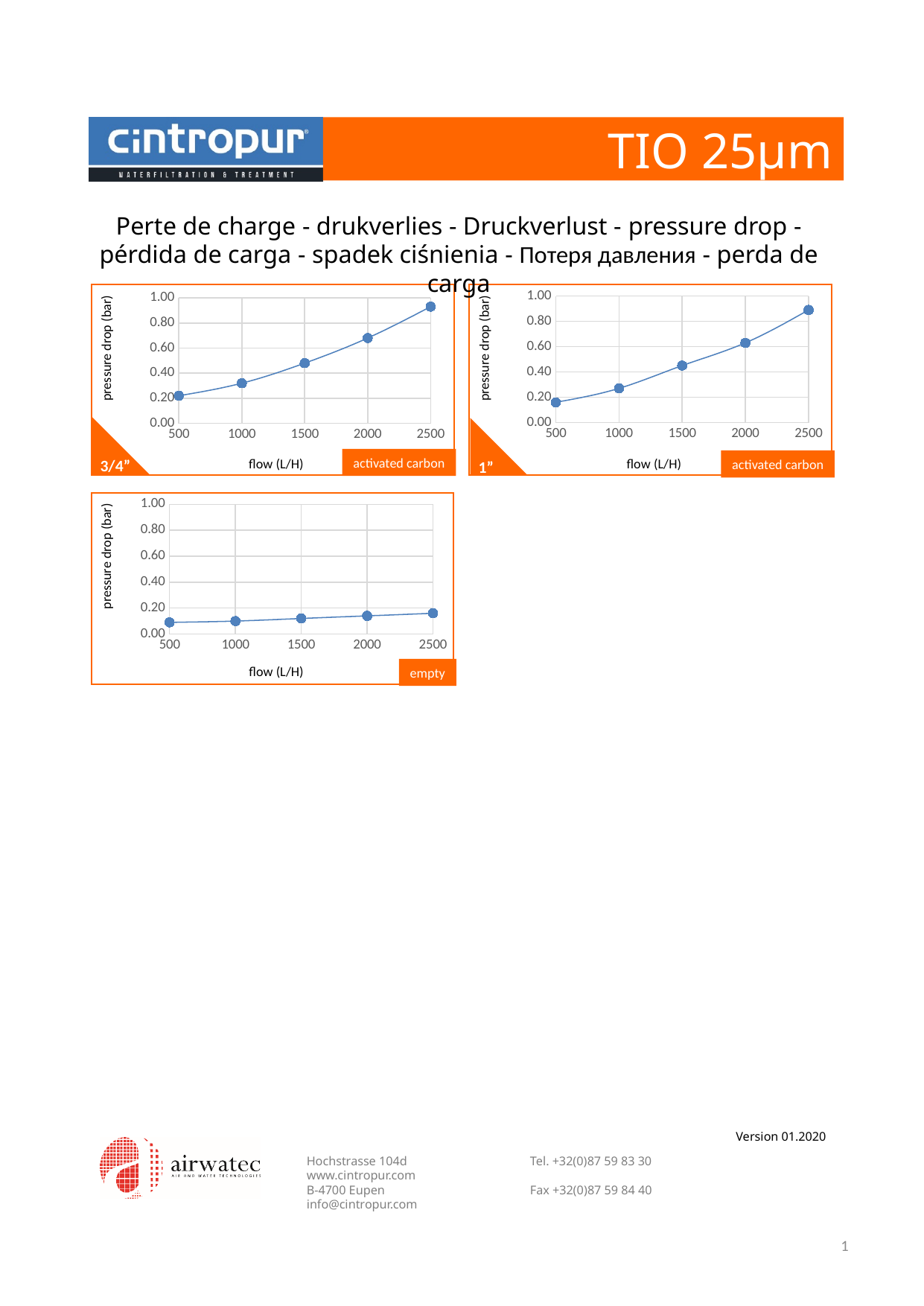
Which chart shows the larger pressure drop at 2500 L/H: the top-left (3/4" activated carbon) chart or the bottom-left (empty) chart? top-left (3/4" activated carbon) In the top-right chart (1" activated carbon), is the pressure drop at 500 L/H greater or less than 0.20 bar? less What is the label on the y axis of the bottom-left chart (empty)? pressure drop (bar) In the top-right chart (1" activated carbon), is the pressure drop at 2000 L/H greater or less than 0.80 bar? less In the top-left chart (3/4" activated carbon), does the pressure drop rise or fall as flow increases? rise In the top-left chart (3/4" activated carbon), what kind of chart is shown? line chart In the top-left chart (3/4" activated carbon), at which flow value is the pressure drop highest? 2500 In the top-right chart (1" activated carbon), at which flow value is the pressure drop lowest? 500 In the top-left chart (3/4" activated carbon), is the pressure drop at 2500 L/H greater or less than 0.80 bar? greater In the bottom-left chart (empty), how many data points are plotted? 5 In the top-left chart (3/4" activated carbon), how many data points are plotted? 5